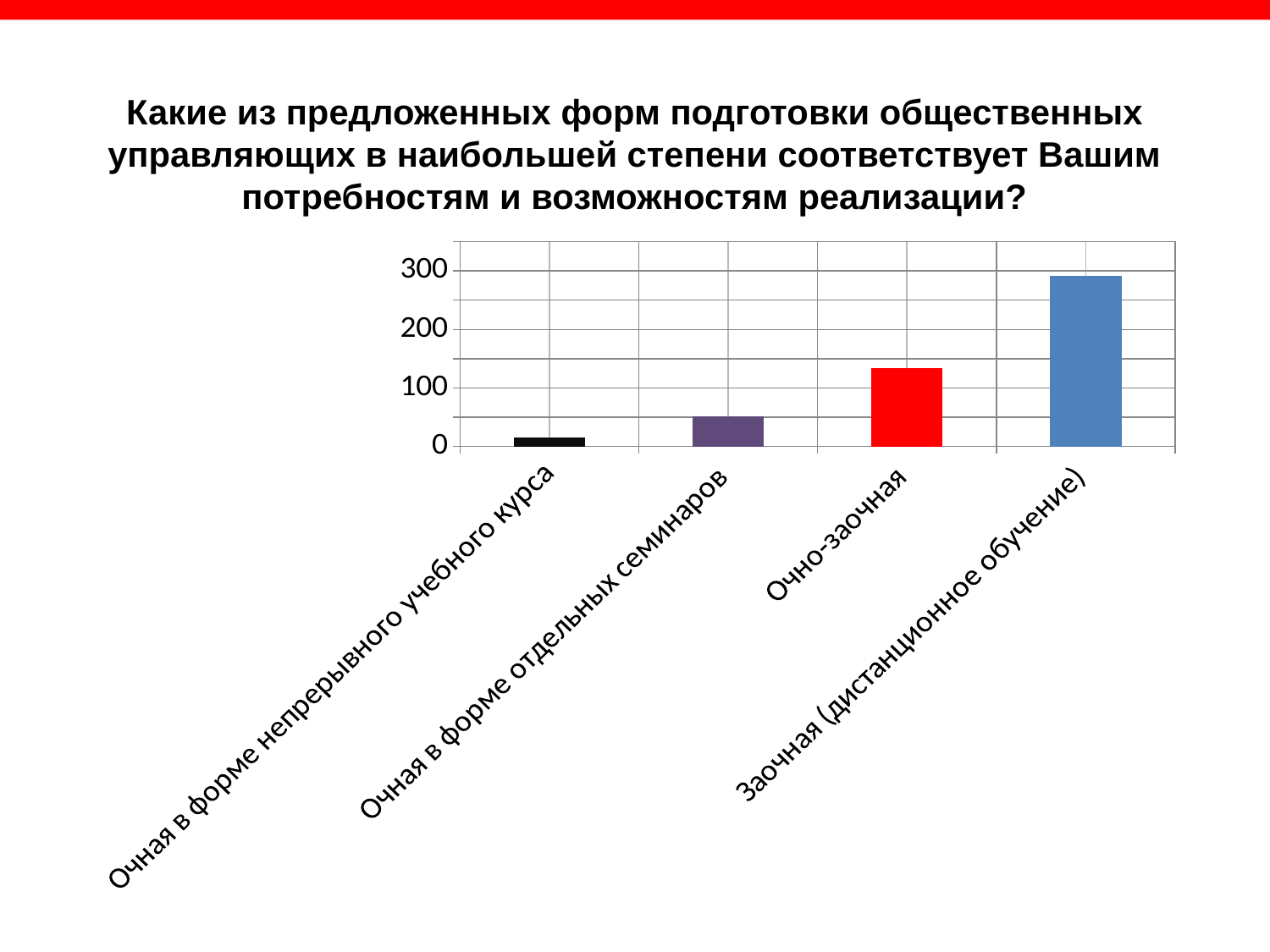
What kind of chart is shown on the slide? bar chart What is the highest value labelled on the vertical axis? 300 Is the value for Очно-заочная greater or less than 100? greater What colour is the bar for Очно-заочная? red Which category has the highest bar? Заочная (дистанционное обучение) Is the value for Очная в форме непрерывного учебного курса greater or less than 100? less How many categories are plotted on the chart? 4 Which category has the lowest bar? Очная в форме непрерывного учебного курса Which is larger: the value for Очно-заочная or the value for Очная в форме отдельных семинаров? Очно-заочная Do the bar values rise or fall from left to right along the x axis? rise Is the value for Очная в форме отдельных семинаров greater or less than 100? less